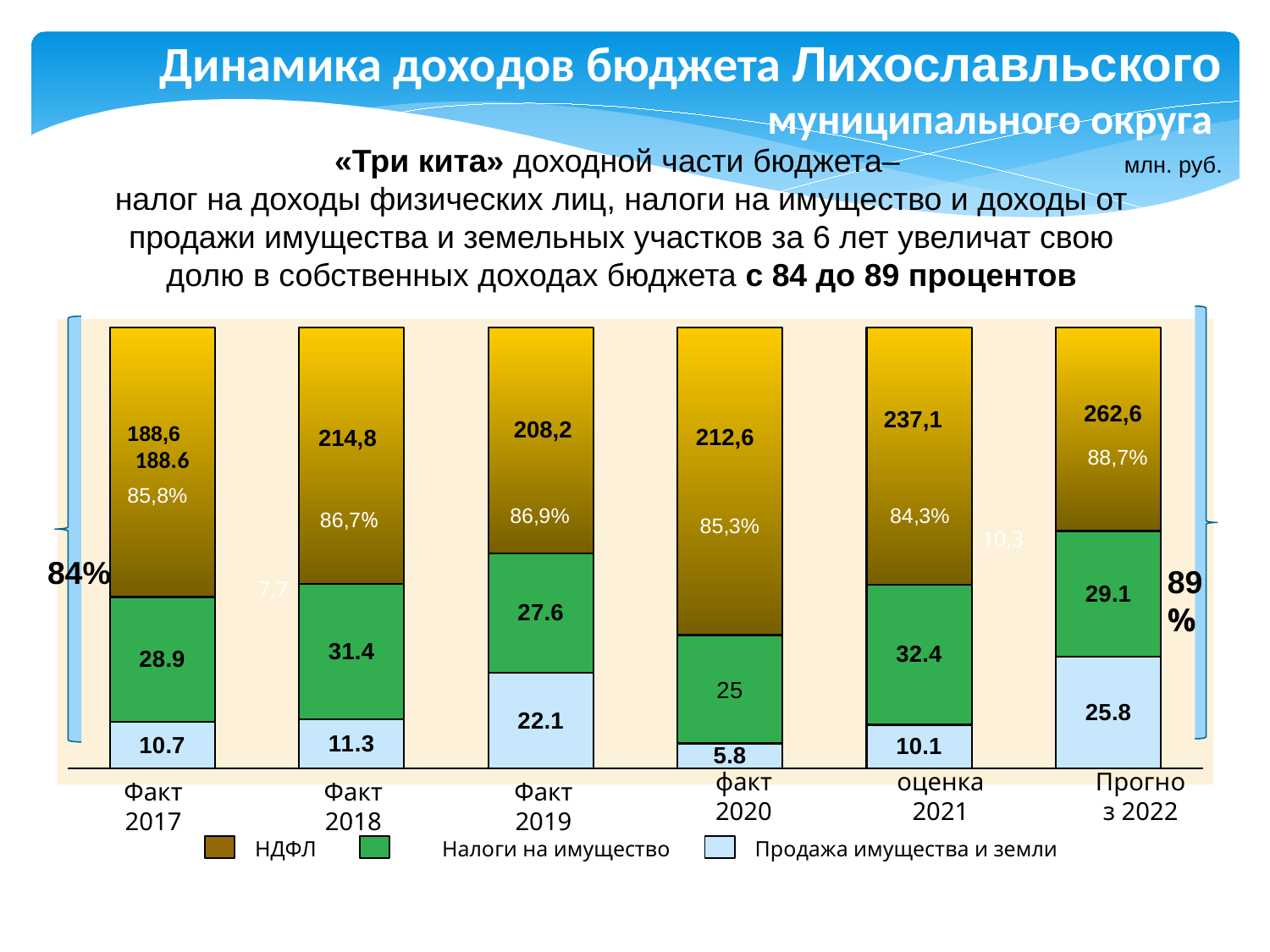
What is the value of НДФЛ for Прогноз 2022? 262,6 How many categories (years) are shown along the x axis? 6 Which is larger, the Налоги на имущество value for Факт 2018 or for Факт 2019? Факт 2018 What are the three series named in the legend? НДФЛ, Налоги на имущество, Продажа имущества и земли How many series does the legend list? 3 In which category is the НДФЛ value the highest? Прогноз 2022 What is the value of Продажа имущества и земли for факт 2020? 5.8 In which category is the Продажа имущества и земли value the lowest? факт 2020 What is the value of Налоги на имущество for оценка 2021? 32.4 What percentage is shown on the НДФЛ segment for Факт 2019? 86,9% What is the difference between the НДФЛ values for Прогноз 2022 and оценка 2021? 25,5 What kind of chart is shown on the slide? Stacked bar chart